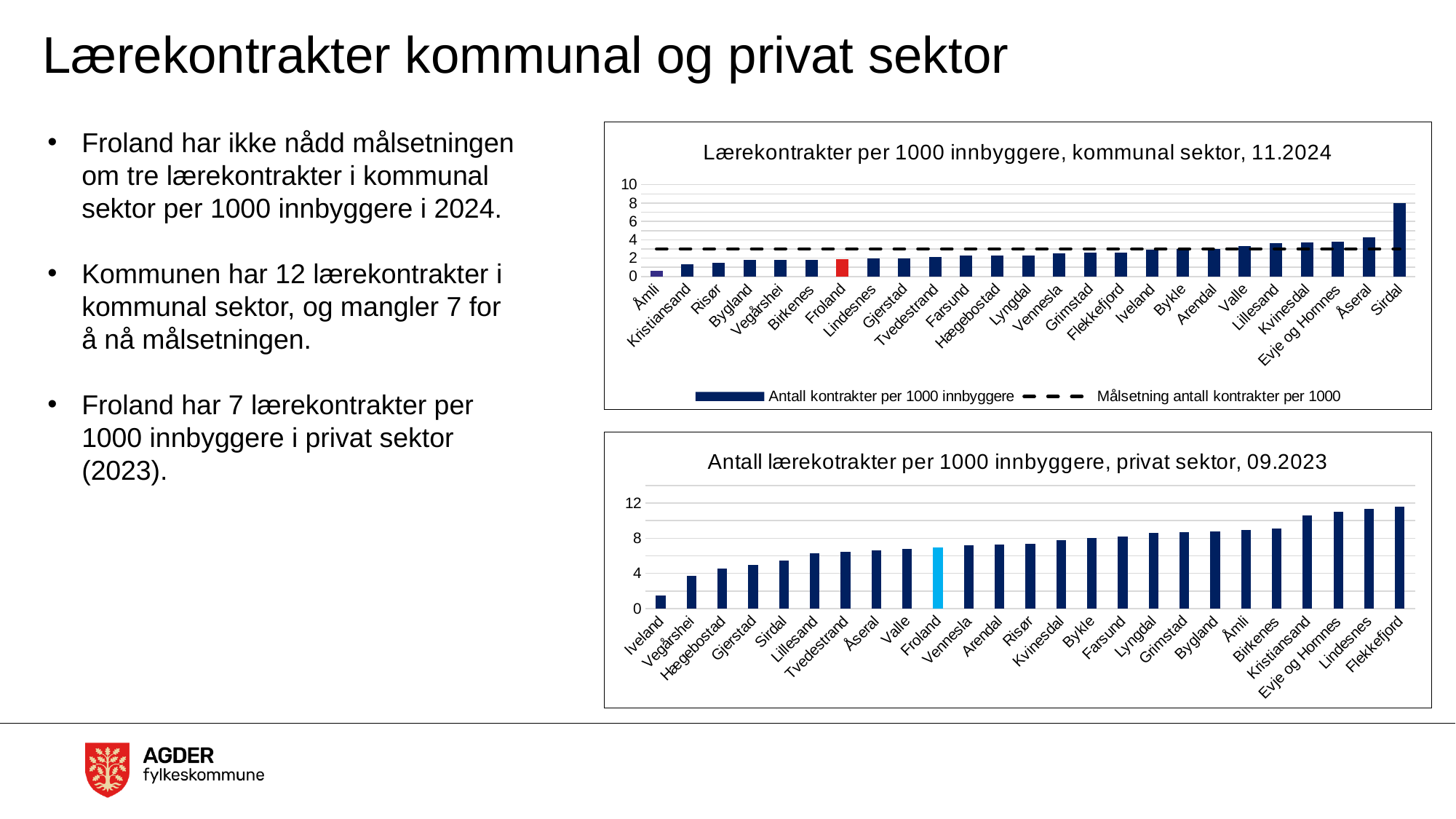
What kind of chart is the bottom chart (privat sektor, 09.2023)? Bar chart In the bottom chart (privat sektor, 09.2023), which municipality has the lowest value? Iveland In the top chart (kommunal sektor, 11.2024), which municipality has the lowest value? Åmli In the bottom chart (privat sektor, 09.2023), is the value for Flekkefjord greater or less than 8? greater In the bottom chart (privat sektor, 09.2023), is the value for Iveland greater or less than 4? less In the top chart (kommunal sektor, 11.2024), is the value for Sirdal greater or less than 6? greater In the top chart (kommunal sektor, 11.2024), which municipality has the highest value? Sirdal In the top chart (kommunal sektor, 11.2024), how many municipalities are shown on the x axis? 25 In the bottom chart (privat sektor, 09.2023), do the values rise or fall from left to right along the x axis? Rise In the bottom chart (privat sektor, 09.2023), which municipality has the highest value? Flekkefjord How many entries does the legend of the top chart (kommunal sektor, 11.2024) list? 2